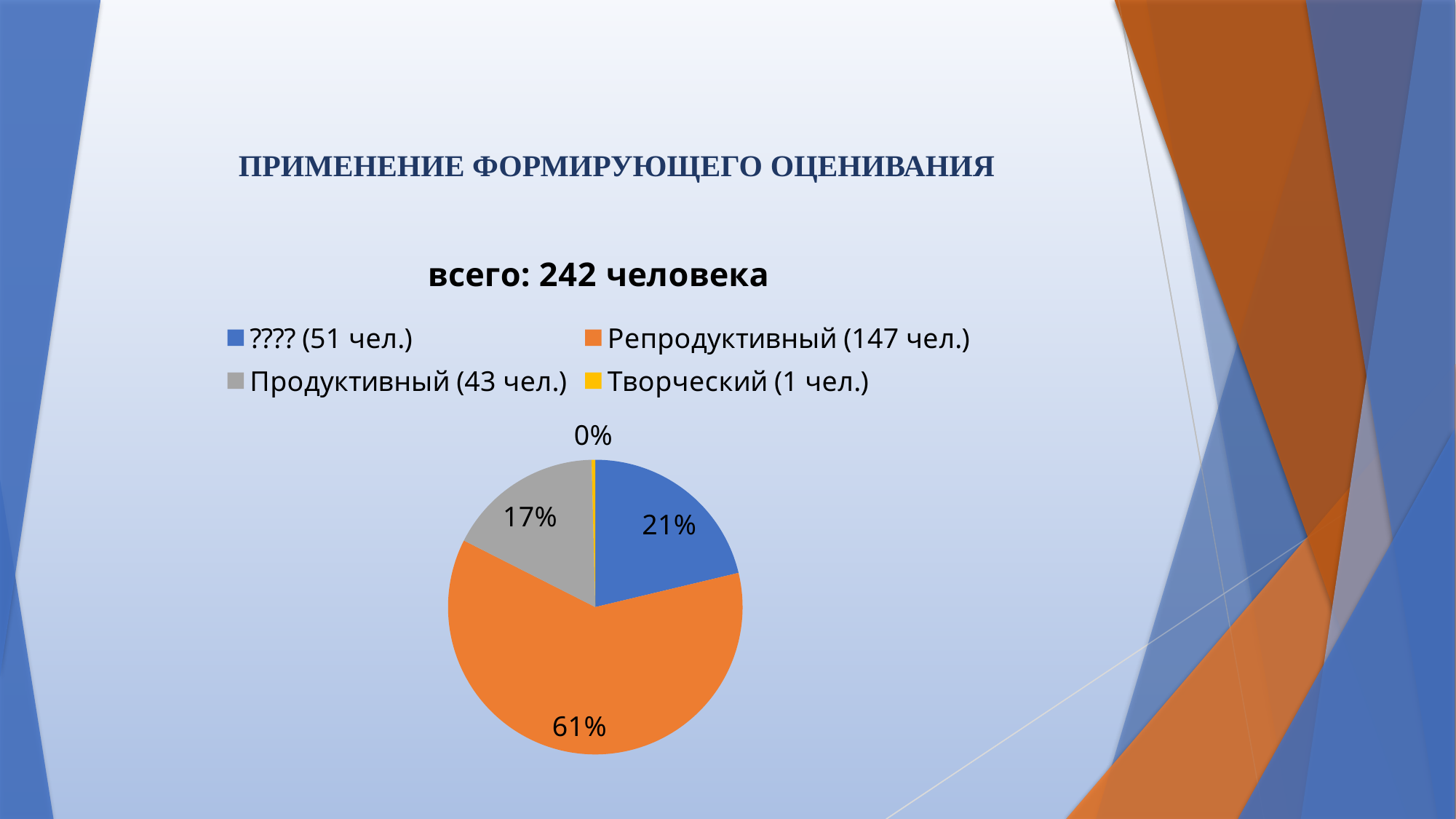
What share of the pie does Продуктивный take? 17% Which is larger, the slice for Репродуктивный or the slice for Продуктивный? Репродуктивный What percentage is shown for Творческий? 0% What kind of chart is shown on the slide? pie chart According to the legend, how many people are in the Продуктивный category? 43 чел. What share of the pie does Репродуктивный take? 61% Which category has the largest slice of the pie? Репродуктивный According to the legend, how many people are in the Репродуктивный category? 147 чел. Which category has the smallest slice of the pie? Творческий What is the title of the chart? всего: 242 человека What is the difference in percentage points between the Репродуктивный slice and the Продуктивный slice? 44% How many slices does the pie chart have? 4